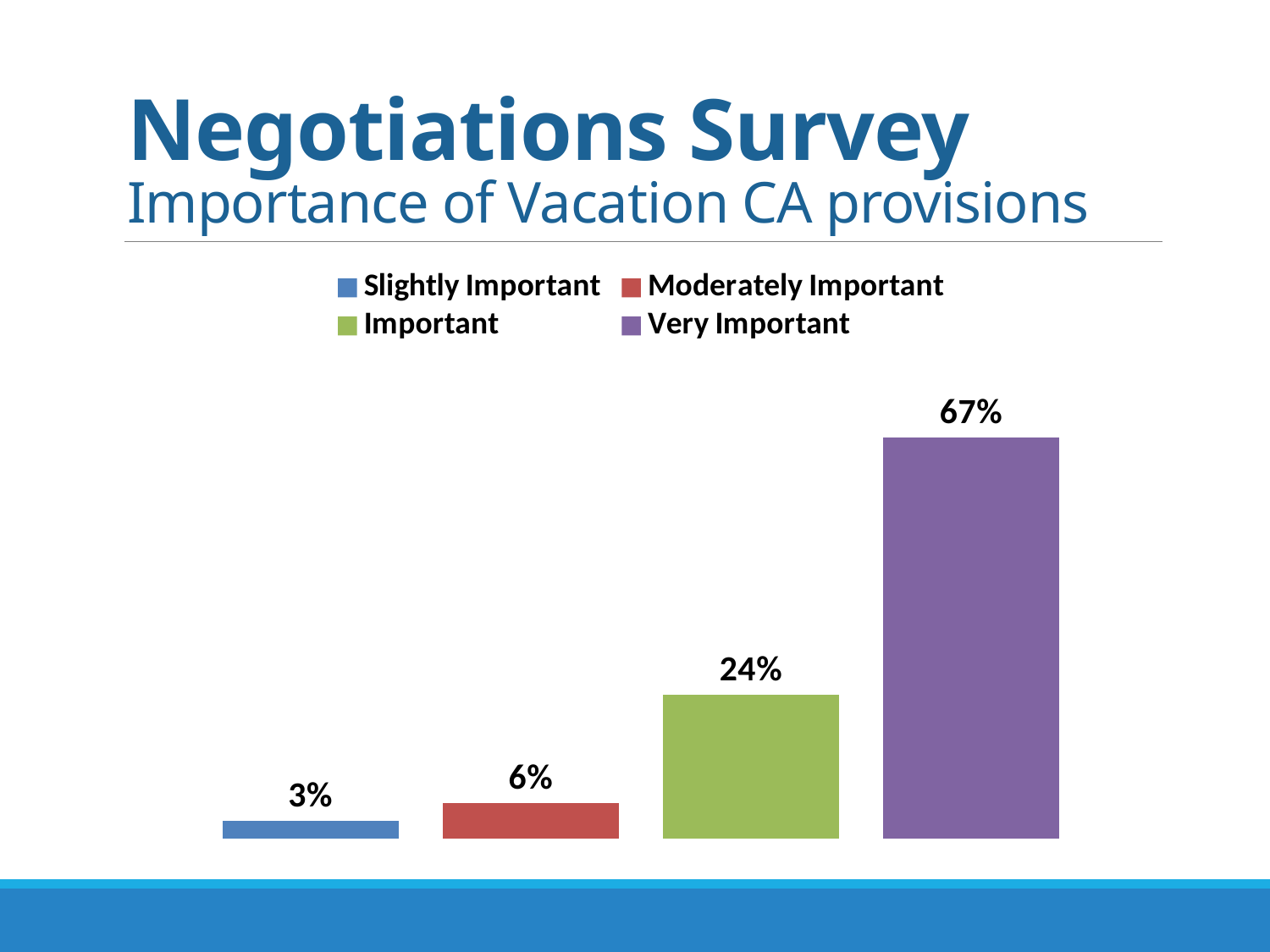
What percentage of respondents rated Vacation CA provisions as Slightly Important? 3% How many bars are shown in the chart? 4 What percentage of respondents rated Vacation CA provisions as Important? 24% How many entries does the legend list? 4 Which rating category has the lowest value? Slightly Important What percentage of respondents rated Vacation CA provisions as Very Important? 67% What is the difference between the Moderately Important and Slightly Important percentages? 3% Which is larger, the value for Important or the value for Moderately Important? Important What is the difference between the Very Important and Important percentages? 43% Which rating category has the highest value? Very Important What type of chart is shown on the slide? Bar chart What percentage of respondents rated Vacation CA provisions as Moderately Important? 6%